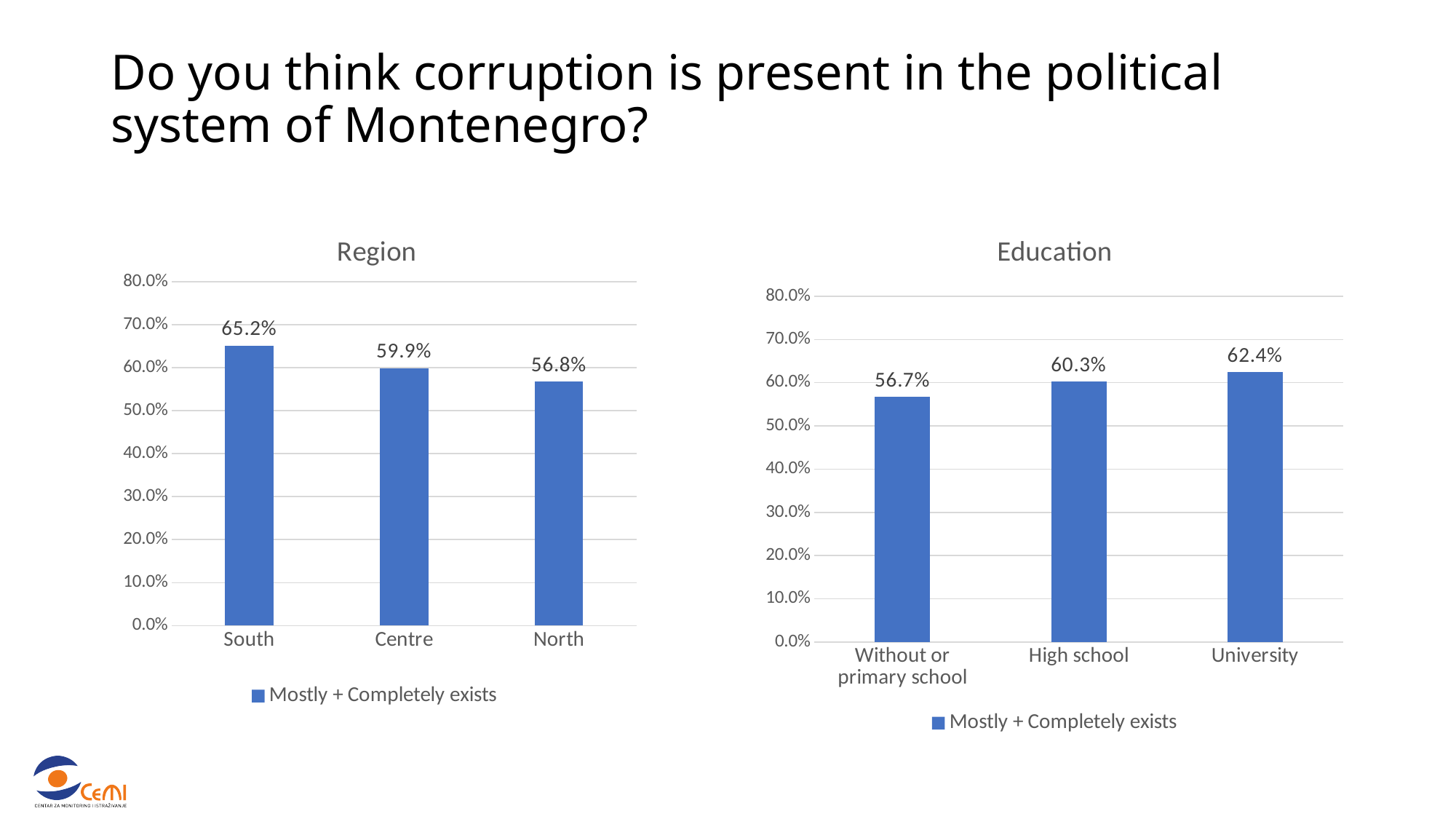
What kind of chart is the Education chart? bar chart In the Education chart, do the values rise or fall from left to right? rise In the Education chart, what is the value for University? 62.4% In the Education chart, what is the difference between the values for University and High school? 2.1% In the Education chart, which is larger, the value for High school or the value for Without or primary school? High school In the Education chart, what is the value for Without or primary school? 56.7% In the Education chart, which education level has the lowest value? Without or primary school In the Region chart, how many regions are shown? 3 In the Region chart, what is the difference between the values for South and North? 8.4% In the Region chart, what is the value for Centre? 59.9% In the Region chart, what is the value for South? 65.2% In the Region chart, which region has the highest value? South